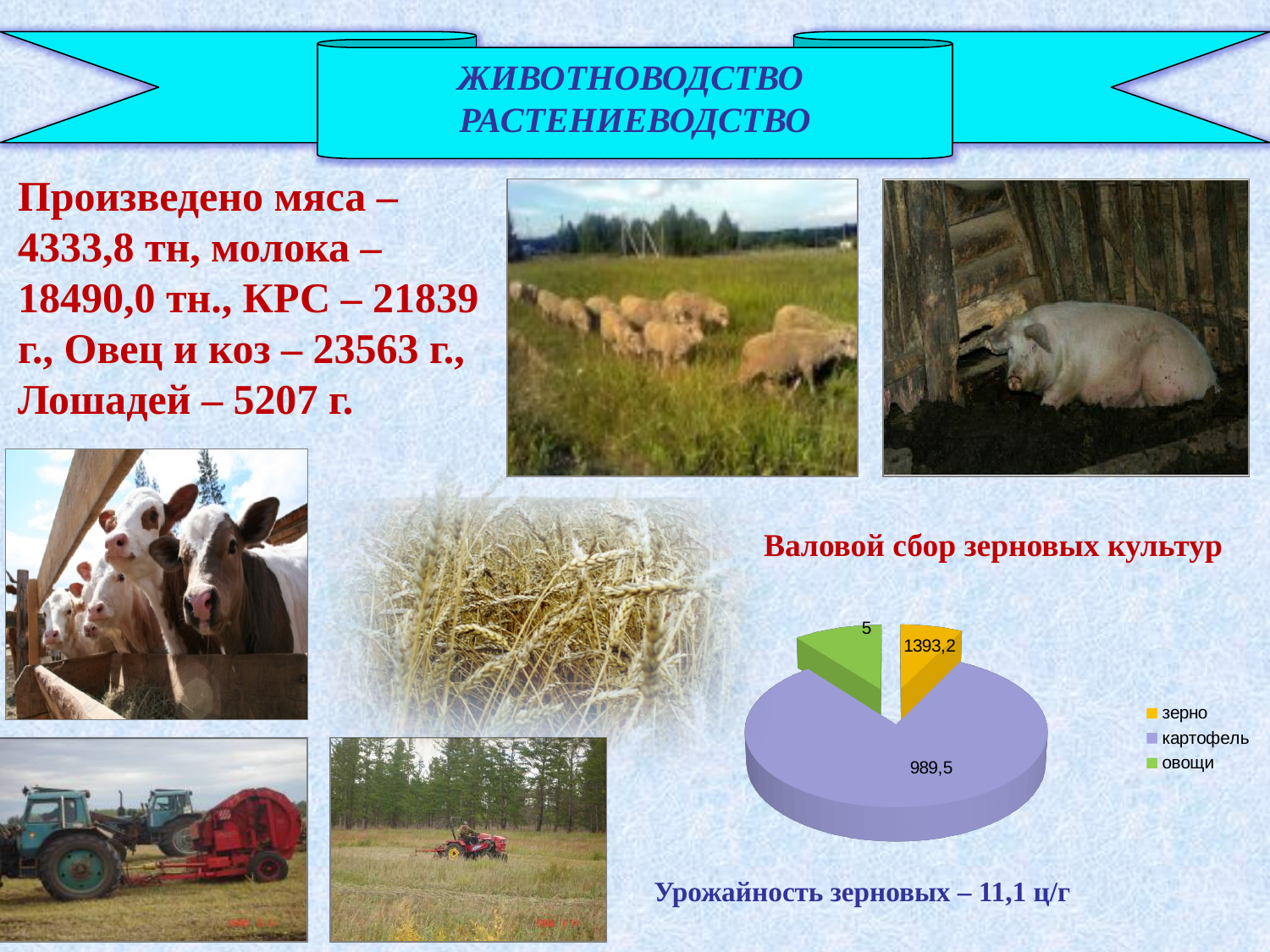
What is the value shown for зерно in the pie chart? 1393,2 What kind of chart is shown on the slide? Pie chart What is the difference between the values labelled for зерно and картофель? 403,7 How many entries does the legend of the pie chart list? 3 How many slices does the pie chart have? 3 What is the title of the pie chart? Валовой сбор зерновых культур What is the value shown for картофель in the pie chart? 989,5 What is the value shown for овощи in the pie chart? 5 What is the total of the three values labelled on the pie chart? 2387,7 Which legend entry is shown in green in the pie chart? овощи